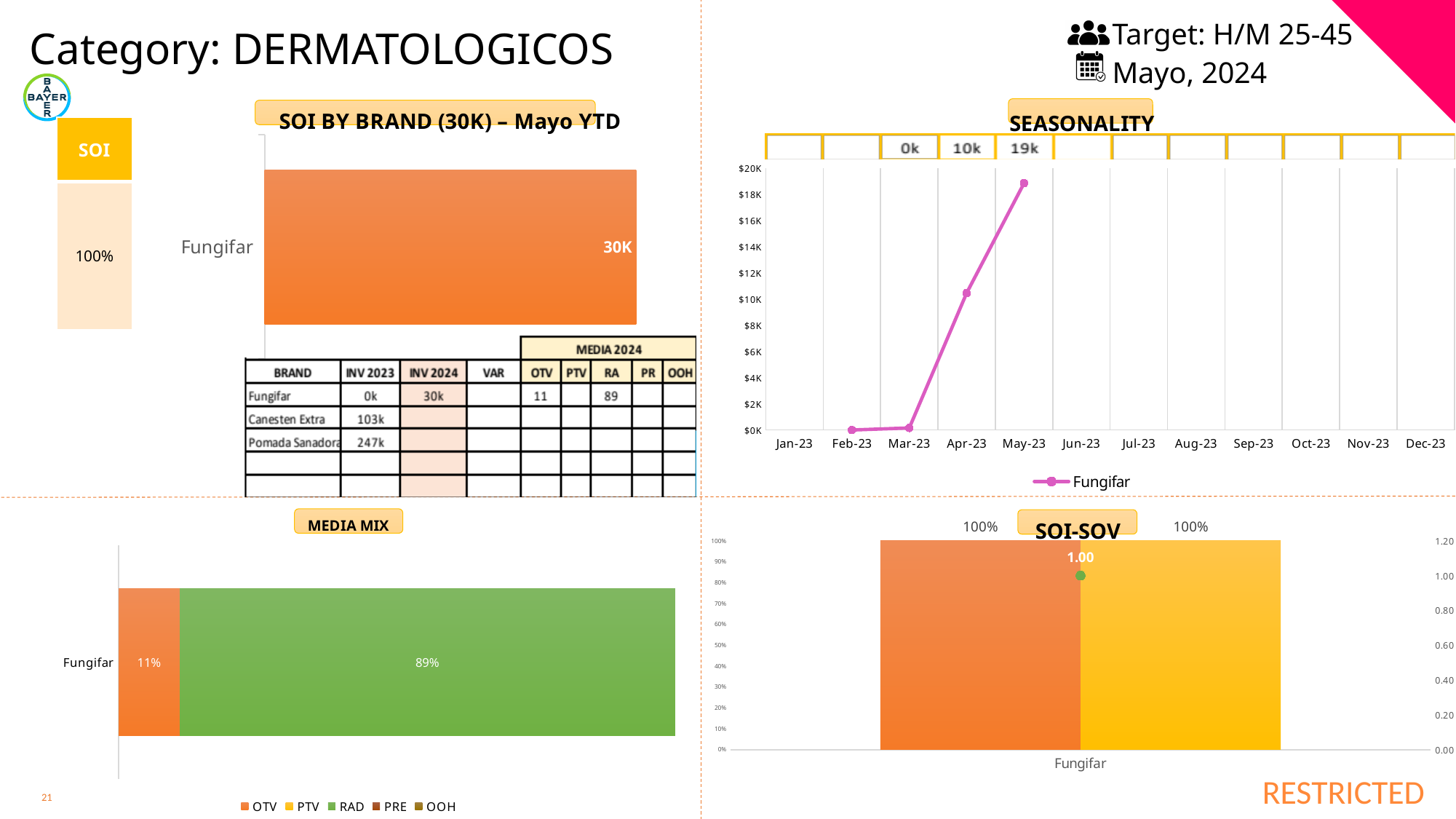
In the SEASONALITY chart, is the value for Apr-23 greater or less than $8K? greater In the MEDIA MIX chart, what is the difference between the RAD share and the OTV share for Fungifar? 78% In the SEASONALITY chart, do the values rise or fall from Mar-23 to May-23? rise In the SEASONALITY chart, is the value for May-23 greater or less than $16K? greater In the SOI BY BRAND chart, what is the value shown for Fungifar? 30K In the MEDIA MIX chart, what percentage of Fungifar's media mix is OTV? 11% What kind of chart is the SOI BY BRAND chart? bar chart In the SOI-SOV chart, what is the value of the marker shown for Fungifar? 1.00 How many brands are plotted in the SOI BY BRAND chart? 1 In the MEDIA MIX chart, which is larger for Fungifar, OTV or RAD? RAD How many series does the legend of the MEDIA MIX chart list? 5 In the MEDIA MIX chart, what percentage of Fungifar's media mix is RAD? 89%